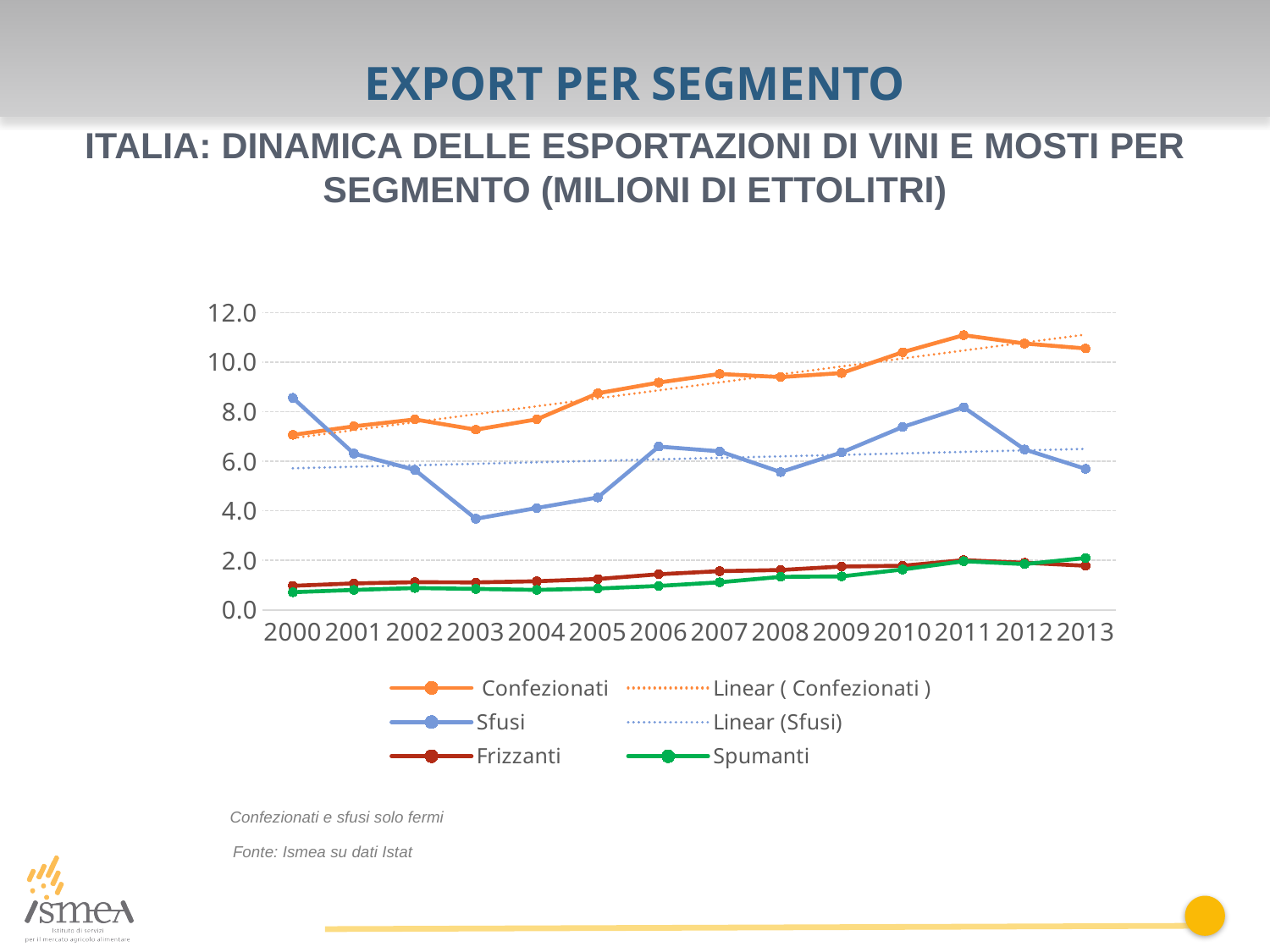
Is the value for Confezionati in 2011 greater or less than 10.0? greater Is the value for Frizzanti in 2000 greater or less than 2.0? less In which year does the Confezionati series reach its highest value? 2011 How many years are plotted along the x axis? 14 Which series has the larger value in 2013, Confezionati or Sfusi? Confezionati Is the value for Sfusi in 2000 greater or less than 8.0? greater In which year does the Sfusi series reach its lowest value? 2003 What kind of chart is shown on the slide? line chart Does the Confezionati series generally rise or fall from 2000 to 2013? rise What unit of measure is stated in the chart title? milioni di ettolitri How many entries does the legend list? 6 Which series has the larger value in 2000, Confezionati or Sfusi? Sfusi